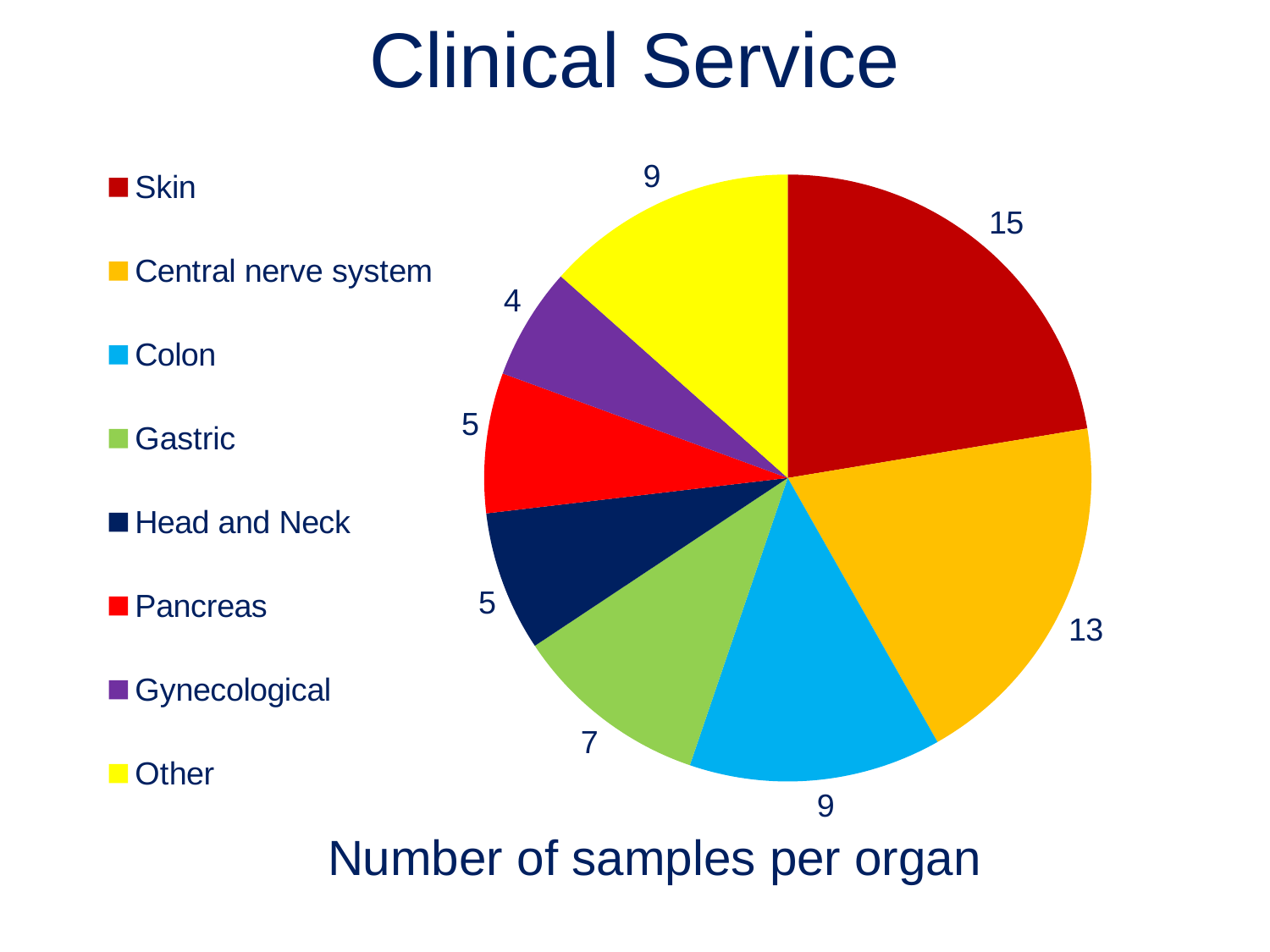
What is the difference in samples between Skin and Central nerve system? 2 How many samples are shown for Central nerve system? 13 Which has more samples, Colon or Gastric? Colon How many samples are shown for Gynecological? 4 What is the total number of samples across all categories in the pie chart? 67 How many samples are shown for Gastric? 7 How many categories does the pie chart show? 8 How many samples are shown for Skin? 15 What kind of chart is shown on the slide? pie chart What is the title of the chart? Clinical Service Which organ category has the smallest number of samples? Gynecological Which organ category has the largest number of samples? Skin